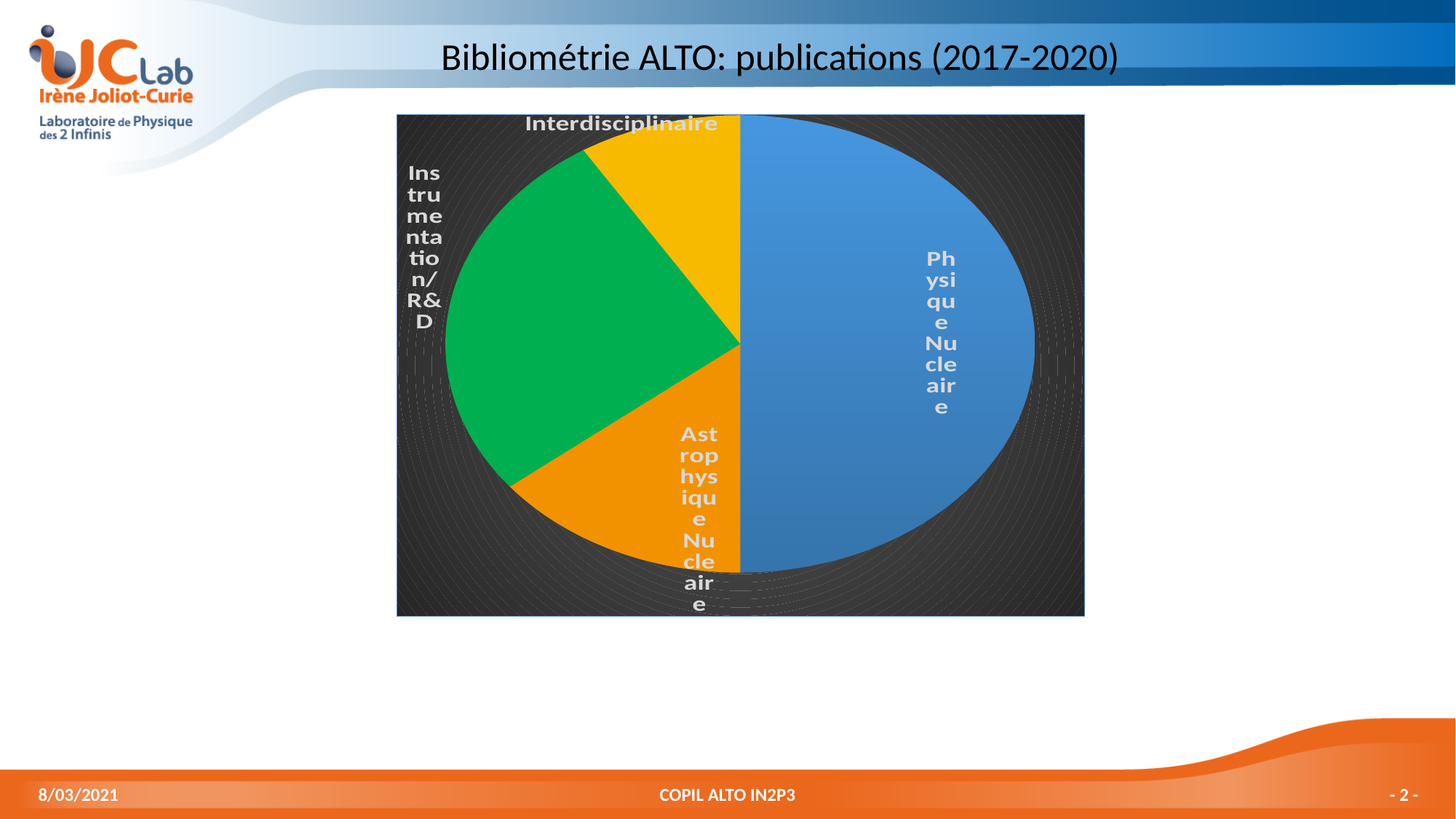
Which slice is larger, Physique Nucleaire or Instrumentation/R&D? Physique Nucleaire How many slices does the pie chart have? 4 Which slice is larger, Astrophysique Nucleaire or Interdisciplinaire? Astrophysique Nucleaire What colour is the Physique Nucleaire slice of the pie chart? blue What kind of chart is shown on the slide? pie chart Which slice is larger, Instrumentation/R&D or Astrophysique Nucleaire? Instrumentation/R&D Which category has the largest slice of the pie chart? Physique Nucleaire Which category is shown in green on the pie chart? Instrumentation/R&D Which category has the smallest slice of the pie chart? Interdisciplinaire